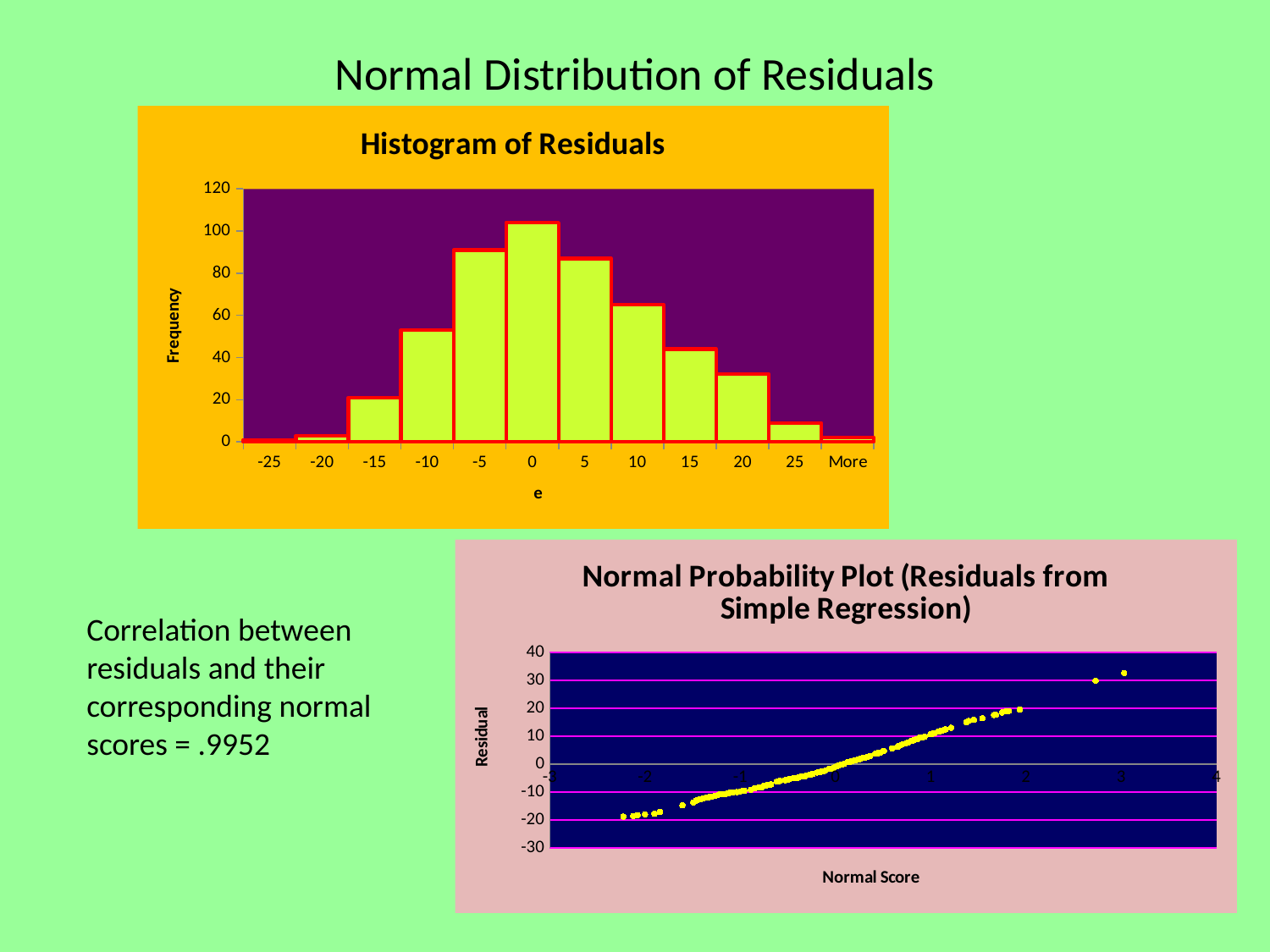
What kind of chart is the 'Histogram of Residuals'? bar chart What is the x-axis title of the 'Normal Probability Plot'? Normal Score In the 'Histogram of Residuals', is the frequency for the 25 bin greater or less than 20? less In the 'Histogram of Residuals', is the frequency for the -5 bin greater or less than 80? greater In the 'Histogram of Residuals', is the frequency for the 20 bin greater or less than 40? less In the 'Histogram of Residuals', which bin has the highest frequency? 0 In the 'Histogram of Residuals', which bin has the higher frequency, -10 or 10? 10 In the 'Normal Probability Plot', do the residual values rise or fall as the normal score increases? rise In the 'Histogram of Residuals', which bin has the higher frequency, 15 or 20? 15 In the 'Histogram of Residuals', how many bins are shown on the x axis? 12 What kind of chart is the 'Normal Probability Plot (Residuals from Simple Regression)'? scatter plot